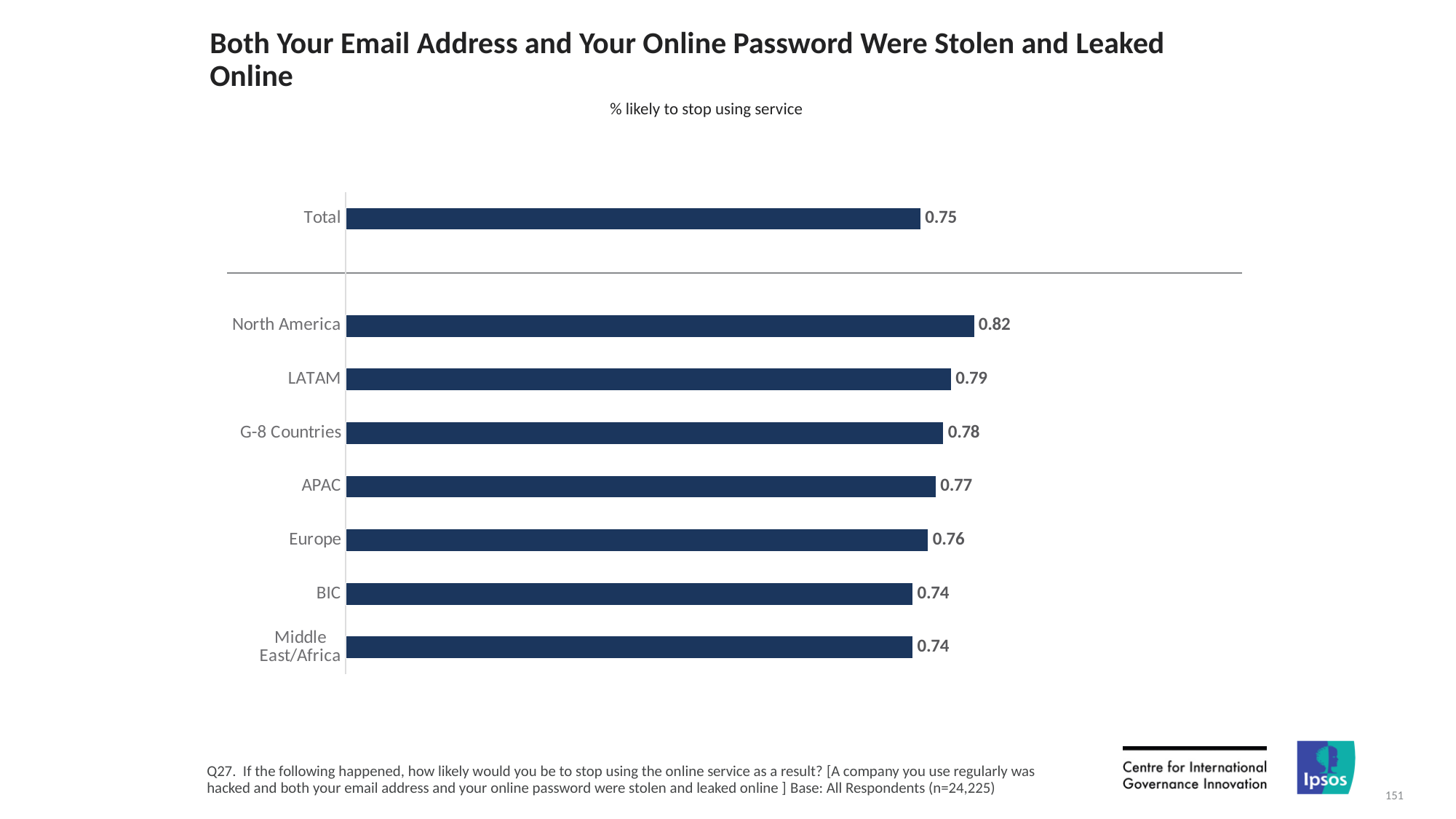
Which is larger, the value for APAC or the value for Europe? APAC What is the difference between the values for G-8 Countries and BIC? 0.04 What is the difference between the values for North America and LATAM? 0.03 Do the values for the regions rise or fall going down from North America to Middle East/Africa? Fall What is the value for Europe? 0.76 How many bars are plotted on the chart, including Total? 8 Which region has the highest value? North America What is the value for North America? 0.82 What kind of chart is shown on the slide? Bar chart What is the value for Total? 0.75 What is the subtitle shown above the chart? % likely to stop using service What is the value for Middle East/Africa? 0.74